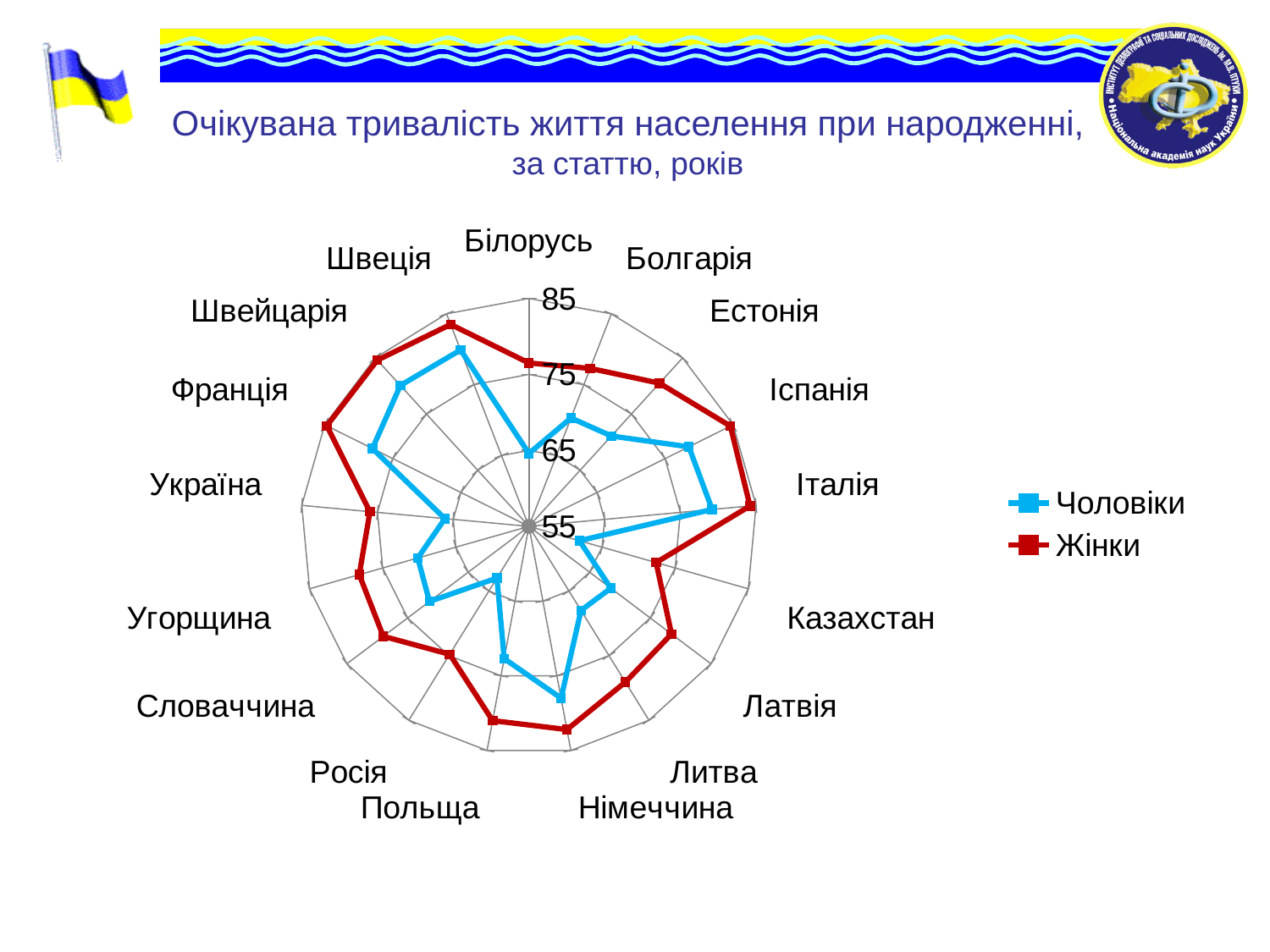
How many series does the legend list? 2 How many countries are plotted on the chart? 17 For Україна, which series has the larger value, Чоловіки or Жінки? Жінки Is the value for Чоловіки in Швеція greater or less than 75? greater Which country has the lowest value for Чоловіки? Казахстан Is the value for Чоловіки in Казахстан greater or less than 65? less What kind of chart is shown on the slide? Radar chart Is the value for Чоловіки in Росія greater or less than 75? less Which series is drawn in red? Жінки What are the two series named in the legend? Чоловіки and Жінки